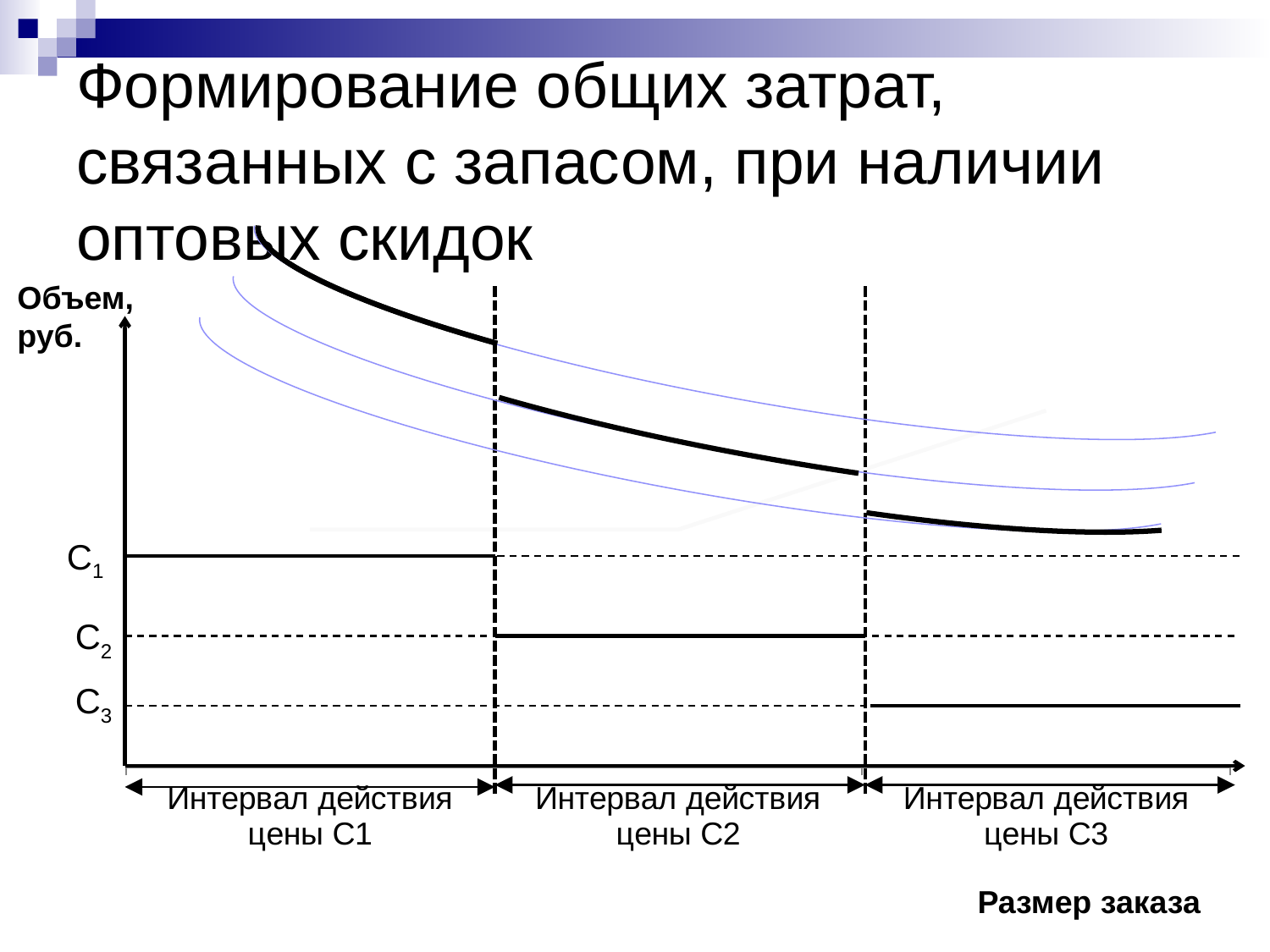
Which of the three price levels C1, C2 and C3 is the highest on the chart? C1 Which price applies in the third (rightmost) interval on the x axis? C3 Which price applies in the first (leftmost) interval on the x axis? C1 Which is larger, price level C2 or price level C3? C2 What is the label of the horizontal axis? Размер заказа Which of the three price levels C1, C2 and C3 is the lowest on the chart? C3 Which is larger, price level C1 or price level C3? C1 How many price intervals are marked along the x axis? 3 Do the price levels rise or fall as the order size increases along the x axis? fall Does the thick total cost curve generally rise or fall as the order size increases? fall What kind of chart is shown on the slide? line chart What is the label of the vertical axis? Объем, руб.